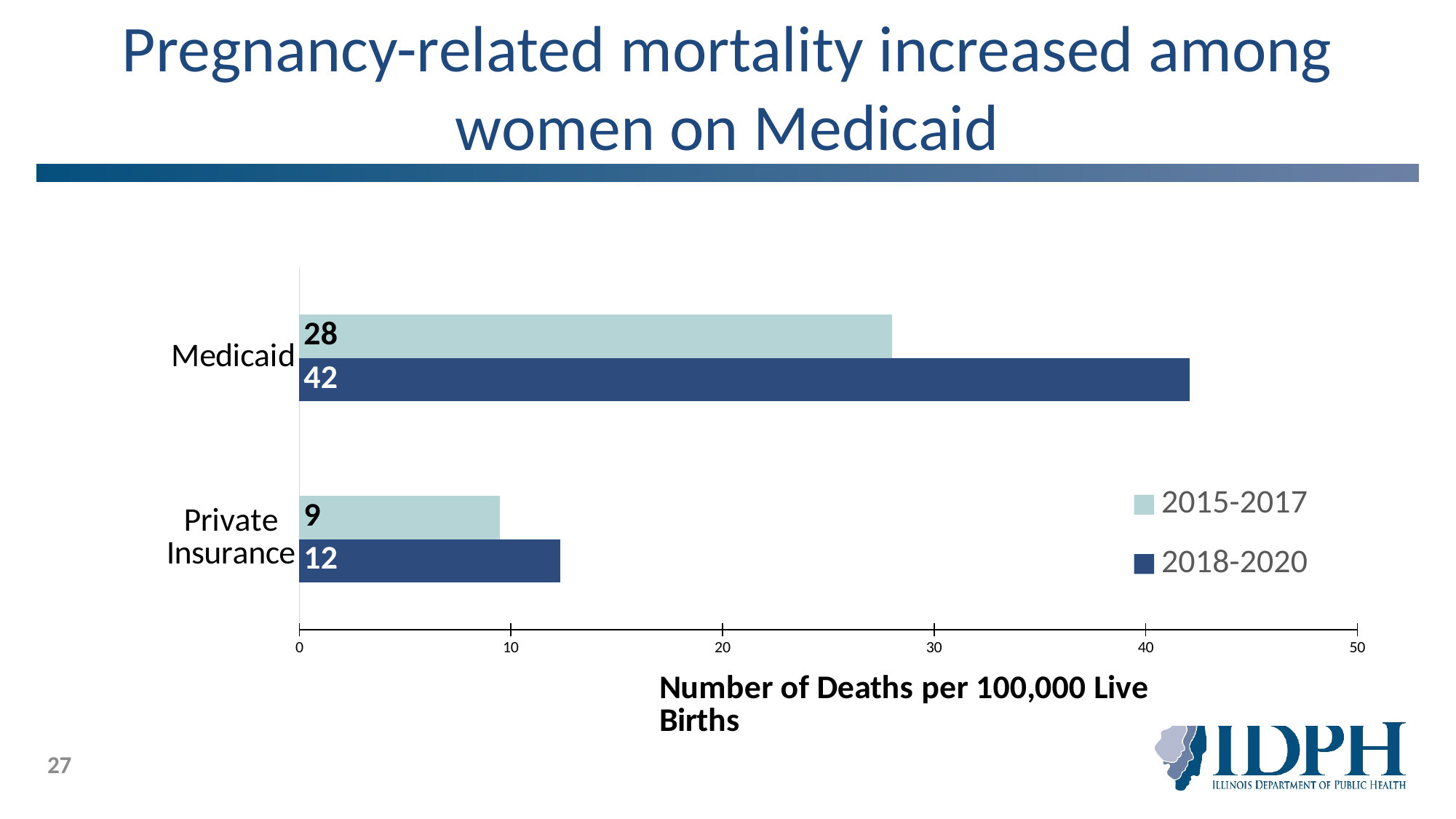
What is the value for Medicaid in the 2015-2017 series? 28 Which category has the highest value in the 2018-2020 series? Medicaid What kind of chart is shown on the slide? Bar chart What is the value for Private Insurance in the 2018-2020 series? 12 What is the value for Medicaid in the 2018-2020 series? 42 Which category has the lowest value in the 2015-2017 series? Private Insurance How many series does the legend list? 2 What is the difference between the Medicaid and Private Insurance values in the 2018-2020 series? 30 What is the value for Private Insurance in the 2015-2017 series? 9 What is the label of the x axis? Number of Deaths per 100,000 Live Births Which is larger: the 2015-2017 value for Medicaid or the 2018-2020 value for Private Insurance? 2015-2017 value for Medicaid What is the difference between the 2018-2020 and 2015-2017 values for Medicaid? 14